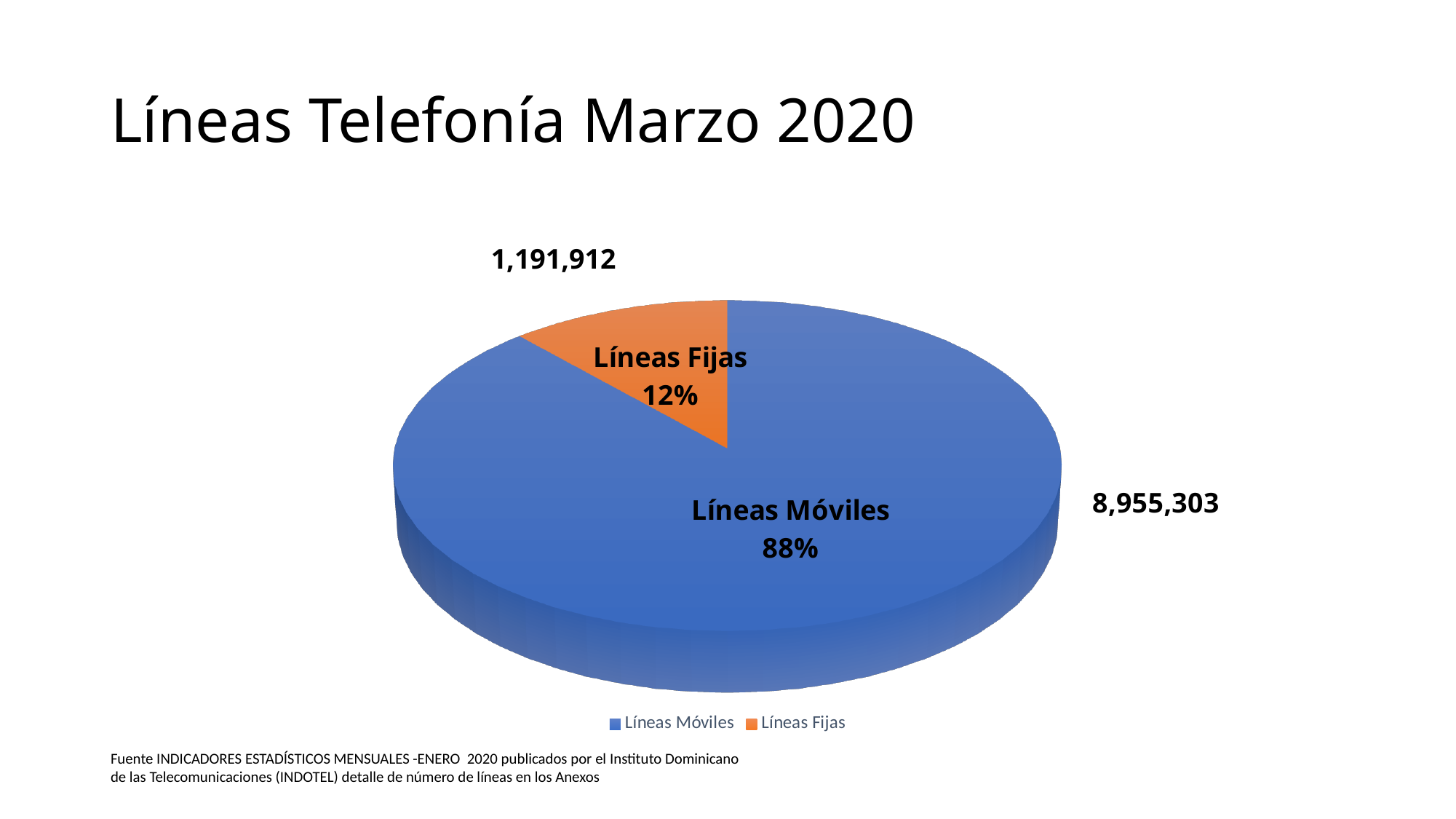
How many categories does the pie chart have? 2 How many entries does the legend list? 2 What share of the pie does Líneas Fijas represent? 12% What kind of chart is shown on the slide? pie chart Which category has the largest slice? Líneas Móviles What is the difference between the values for Líneas Móviles and Líneas Fijas? 7,763,391 What colour is the Líneas Fijas slice? orange Which category has the smallest slice? Líneas Fijas Which is larger, Líneas Móviles or Líneas Fijas? Líneas Móviles What share of the pie does Líneas Móviles represent? 88% What is the value for Líneas Fijas? 1,191,912 What is the value for Líneas Móviles? 8,955,303